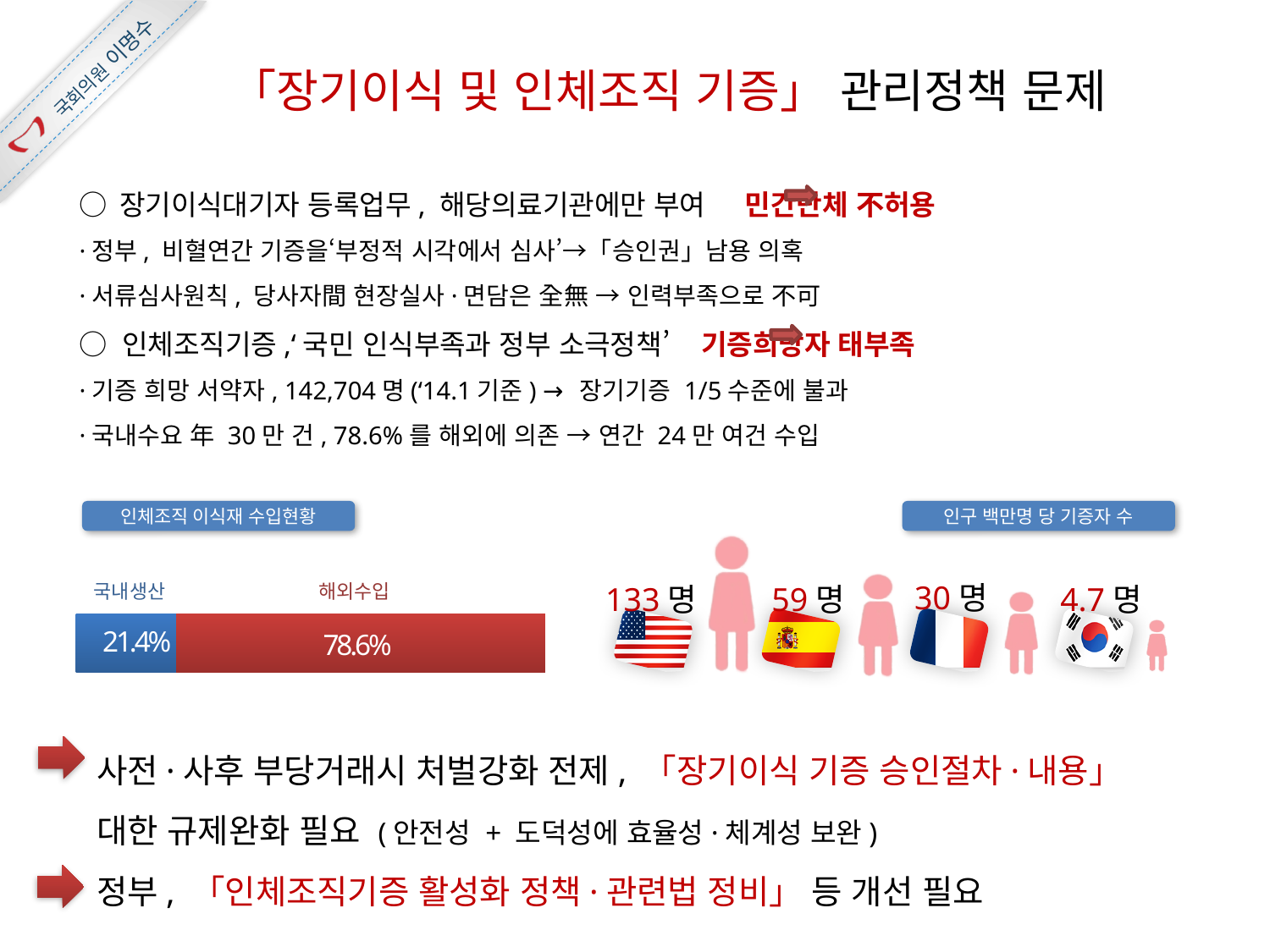
In the '인구 백만명 당 기증자 수' chart, how many countries are shown? 4 What kind of chart is '인체조직 이식재 수입현황'? Stacked bar chart In the '인체조직 이식재 수입현황' chart, what is the difference between 해외수입 and 국내생산? 57.2% In the '인체조직 이식재 수입현황' chart, what is the value for 해외수입? 78.6% In the '인구 백만명 당 기증자 수' chart, what is the value for Spain? 59 명 In the '인체조직 이식재 수입현황' chart, what is the value for 국내생산? 21.4% In the '인구 백만명 당 기증자 수' chart, what is the value for the United States? 133 명 In the '인구 백만명 당 기증자 수' chart, which country has the lowest value? Korea In the '인구 백만명 당 기증자 수' chart, which country has the highest value? United States In the '인체조직 이식재 수입현황' chart, which segment is larger, 국내생산 or 해외수입? 해외수입 In the '인구 백만명 당 기증자 수' chart, what is the value for Korea? 4.7 명 In the '인체조직 이식재 수입현황' chart, what is the total of the two segments of the bar? 100%